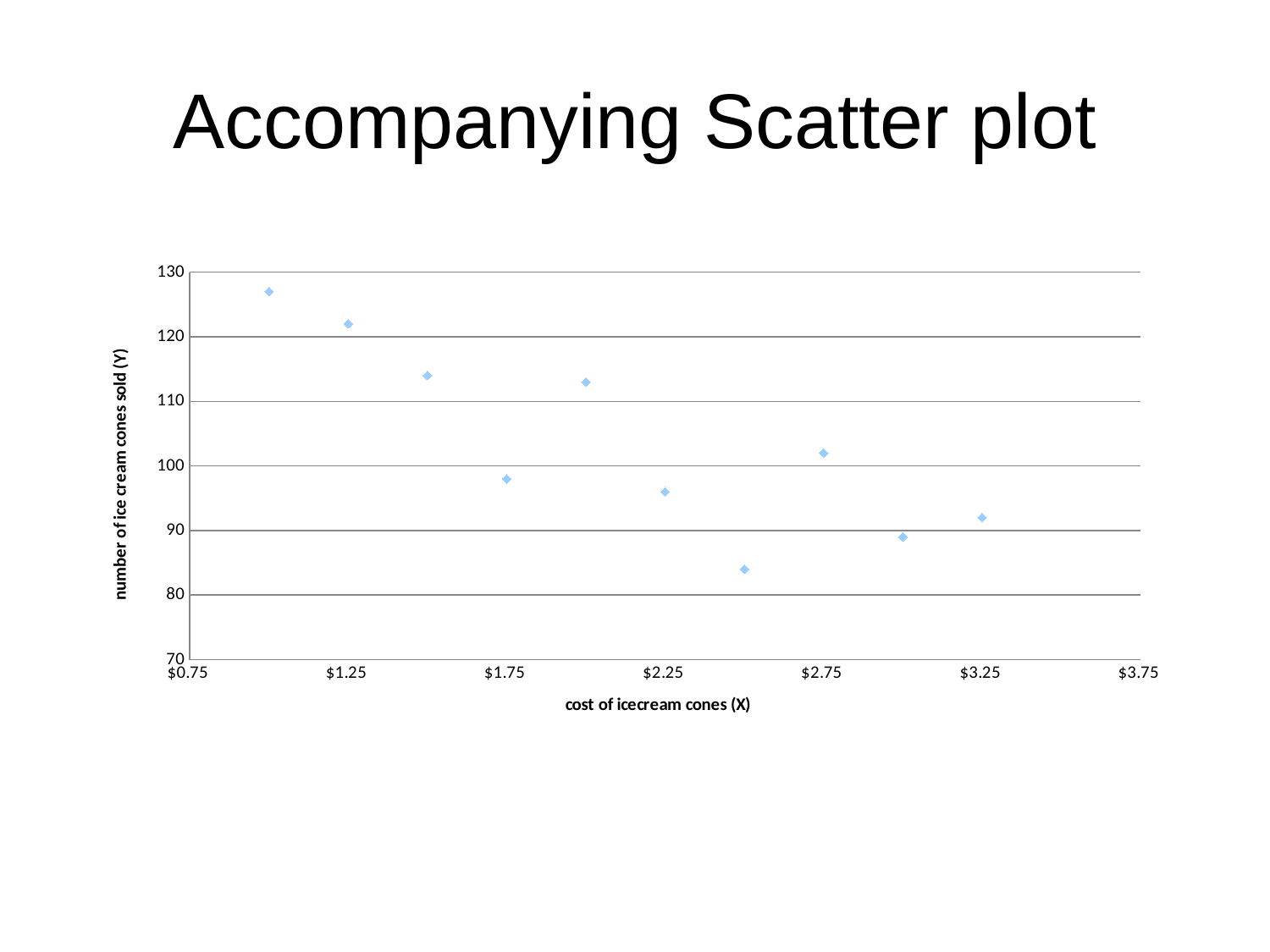
Overall, do the number of cones sold rise or fall as the cost of cones increases? fall What is the title of the x axis? cost of icecream cones (X) Is the number of cones sold at a cost of $2.50 greater or less than 90? less Is the number of cones sold at a cost of $2.25 greater or less than 100? less Is the number of cones sold at a cost of $1.50 greater or less than 110? greater How many data points are plotted on the scatter plot? 10 What kind of chart is shown on the slide? Scatter plot Which has more cones sold: the point at $1.25 or the point at $2.00? $1.25 Which has more cones sold: the point at $1.75 or the point at $2.00? $2.00